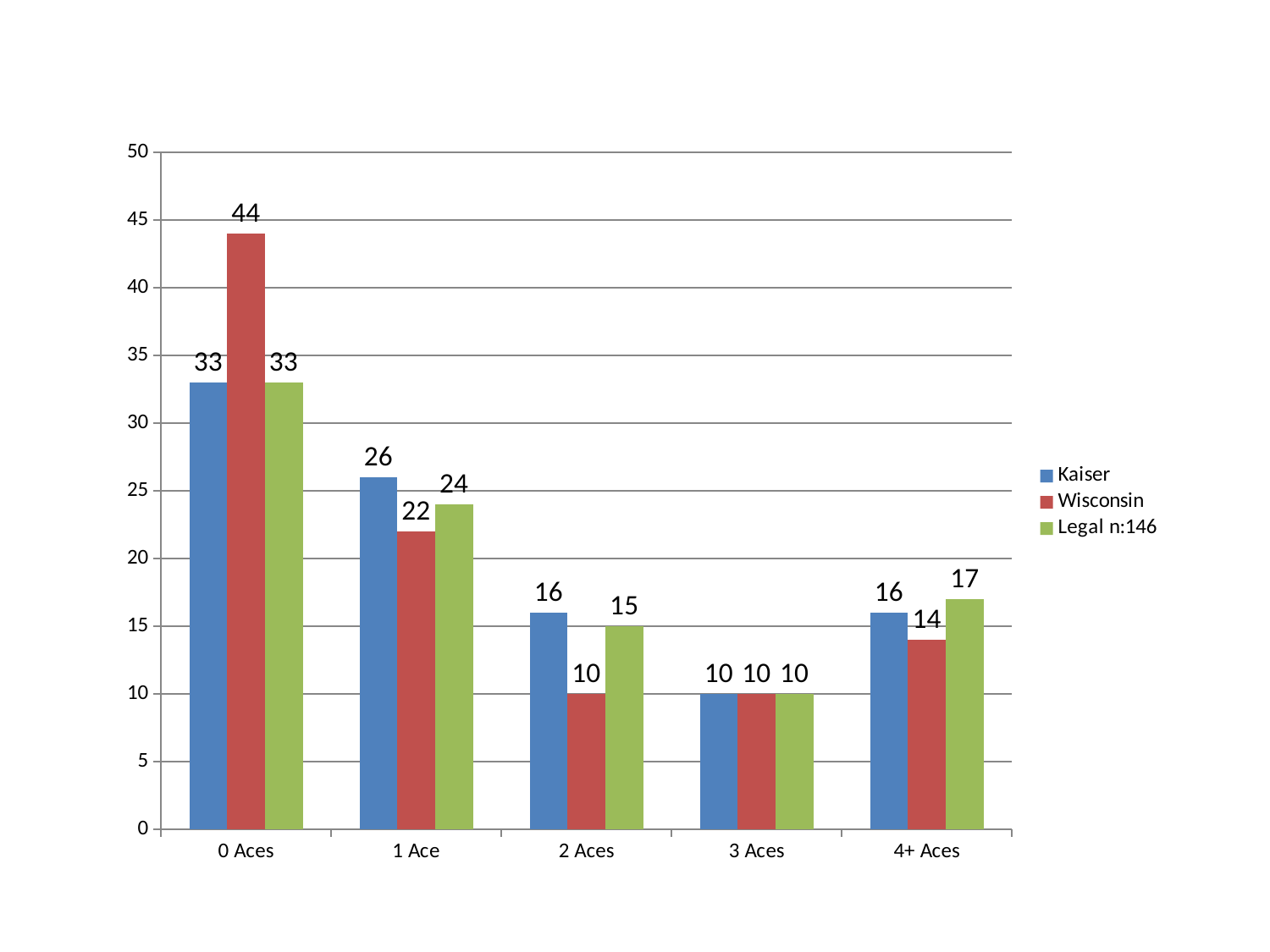
Which is larger at 2 Aces, the Kaiser value or the Legal n:146 value? Kaiser What is the value for Wisconsin at 0 Aces? 44 Does the Wisconsin series rise or fall from 0 Aces to 3 Aces? Fall How many categories are shown on the x axis? 5 What is the value for Legal n:146 at 4+ Aces? 17 What is the difference between the Wisconsin and Kaiser values at 0 Aces? 11 What is the value for Kaiser at 1 Ace? 26 Which category has the highest value for the Wisconsin series? 0 Aces Which category has the lowest value for the Kaiser series? 3 Aces What colour represents the Legal n:146 series? Green What kind of chart is shown on the slide? Bar chart How many series does the legend list? 3